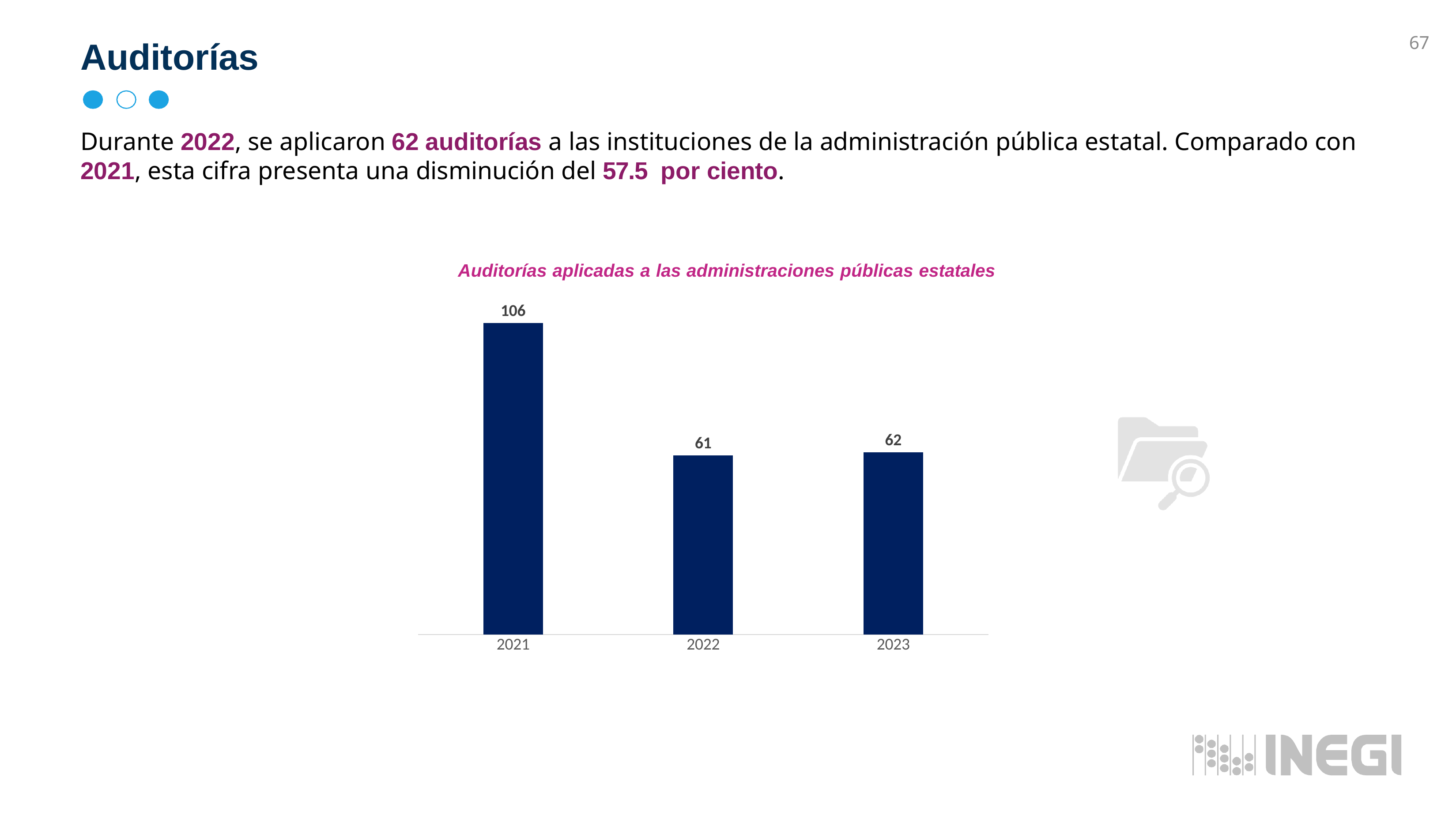
What is the title of the chart? Auditorías aplicadas a las administraciones públicas estatales Which year has the lowest value? 2022 What is the value for 2023? 62 What kind of chart is shown on the slide? bar chart How many years are shown on the chart? 3 Which year has the highest value? 2021 Which is larger, the value for 2021 or the value for 2023? 2021 What is the value for 2022? 61 What is the difference between the values for 2021 and 2022? 45 What is the difference between the values for 2023 and 2022? 1 What colour are the bars in the chart? dark blue What is the value for 2021? 106